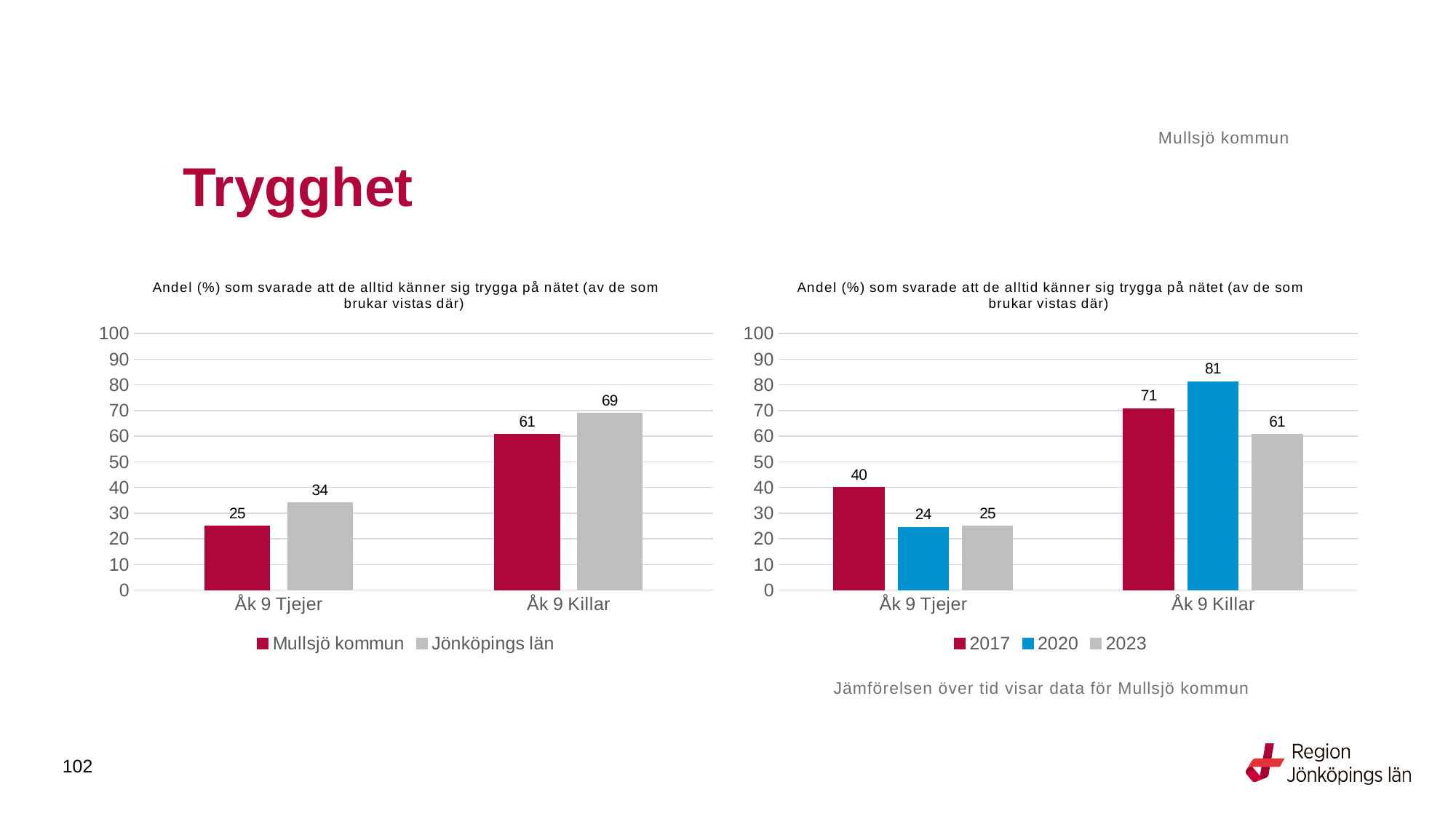
In the right chart, which year has the lowest value for Åk 9 Tjejer? 2020 What kind of chart is the right chart? Bar chart How many series does the legend of the left chart list? 2 In the left chart, what is the value for Mullsjö kommun for Åk 9 Tjejer? 25 In the left chart, which is larger for Åk 9 Killar: Mullsjö kommun or Jönköpings län? Jönköpings län In the left chart, what is the difference between Jönköpings län and Mullsjö kommun for Åk 9 Tjejer? 9 In the right chart, which year has the highest value for Åk 9 Killar? 2020 In the right chart, what is the value for 2017 for Åk 9 Tjejer? 40 How many series does the legend of the right chart list? 3 In the right chart, what is the difference between the 2020 and 2023 values for Åk 9 Killar? 20 In the left chart, what is the value for Jönköpings län for Åk 9 Killar? 69 In the right chart, what is the value for 2020 for Åk 9 Killar? 81